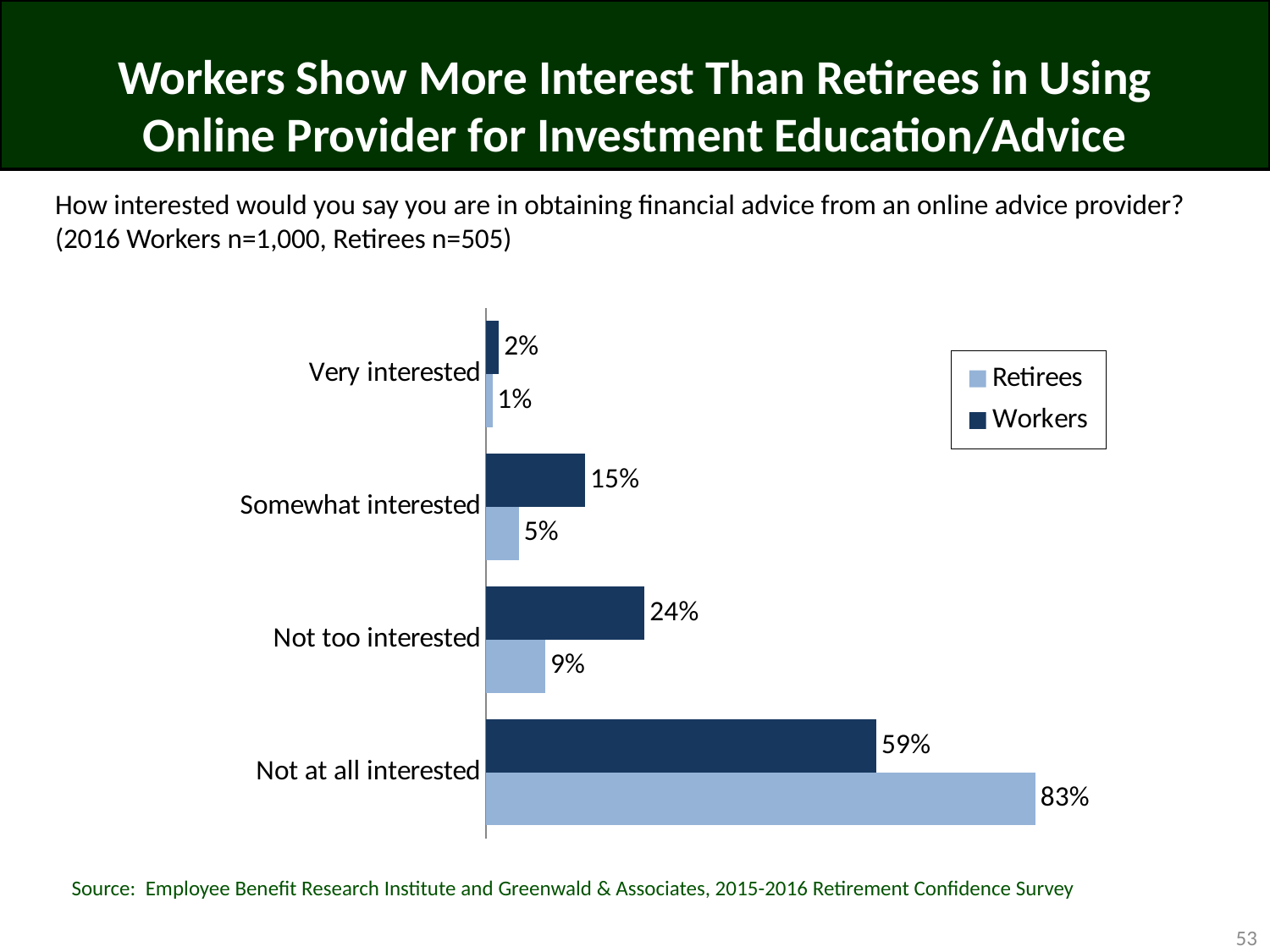
Which is larger for Somewhat interested, the Workers value or the Retirees value? Workers What percentage of Retirees are Somewhat interested? 5% Which category has the lowest value for Workers? Very interested Which category has the highest value for Retirees? Not at all interested What percentage of Workers are Not at all interested? 59% What is the difference between the Retirees and Workers values for Not at all interested? 24% How many categories are shown on the chart? 4 What percentage of Retirees are Very interested? 1% What percentage of Workers are Not too interested? 24% Which series is shown in the darker blue colour? Workers How many series does the legend list? 2 What kind of chart is shown on the slide? Bar chart